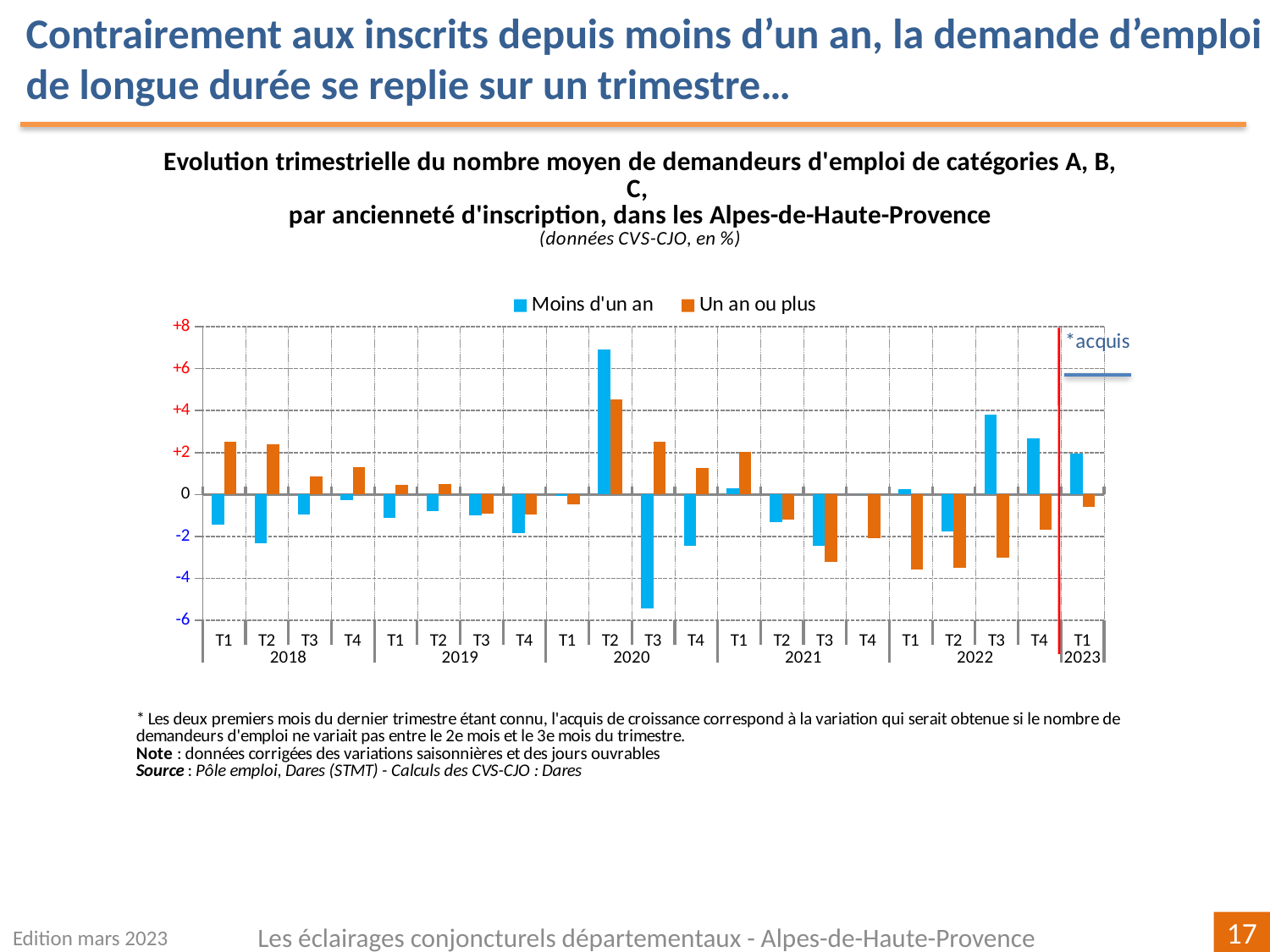
Is the value for 'Un an ou plus' in T3 2021 greater or less than -2? less Is the value for 'Moins d'un an' in T3 2020 greater or less than -4? less Is the value for 'Moins d'un an' in T2 2020 greater or less than +6? greater What kind of chart is shown on the slide? bar chart How many series does the legend list? 2 In which quarter does the 'Un an ou plus' series reach its highest value? T2 2020 In T1 2023, which series has the larger value, 'Moins d'un an' or 'Un an ou plus'? Moins d'un an In which quarter does the 'Moins d'un an' series reach its lowest value? T3 2020 In which quarter does the 'Moins d'un an' series reach its highest value? T2 2020 What does the red vertical line before T1 2023 indicate, according to the label next to it? acquis How many quarters are plotted along the x axis? 21 What are the two series named in the legend? Moins d'un an; Un an ou plus